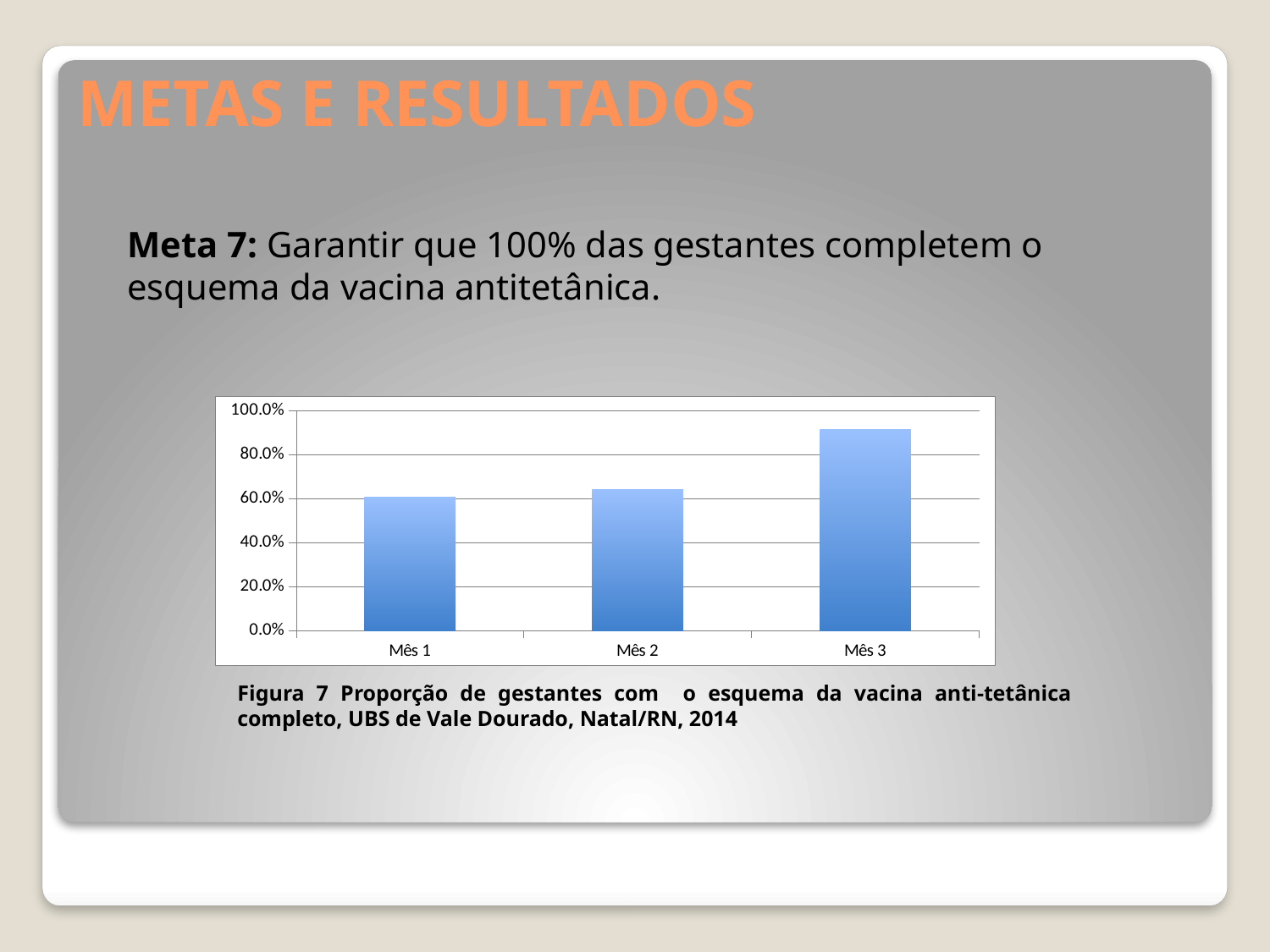
What kind of chart is shown on the slide? bar chart Is the value for Mês 3 greater or less than 80.0%? greater Is the value for Mês 1 greater or less than 40.0%? greater How many categories (months) are plotted on the chart? 3 Is the value for Mês 2 greater or less than 80.0%? less Which month has the highest proportion of pregnant women with the complete anti-tetanus vaccine scheme? Mês 3 What figure number is given in the caption below the chart? Figura 7 Do the values rise or fall from Mês 1 to Mês 3? rise What is the highest value shown on the vertical axis of the chart? 100.0% Which is larger, the value for Mês 3 or the value for Mês 1? Mês 3